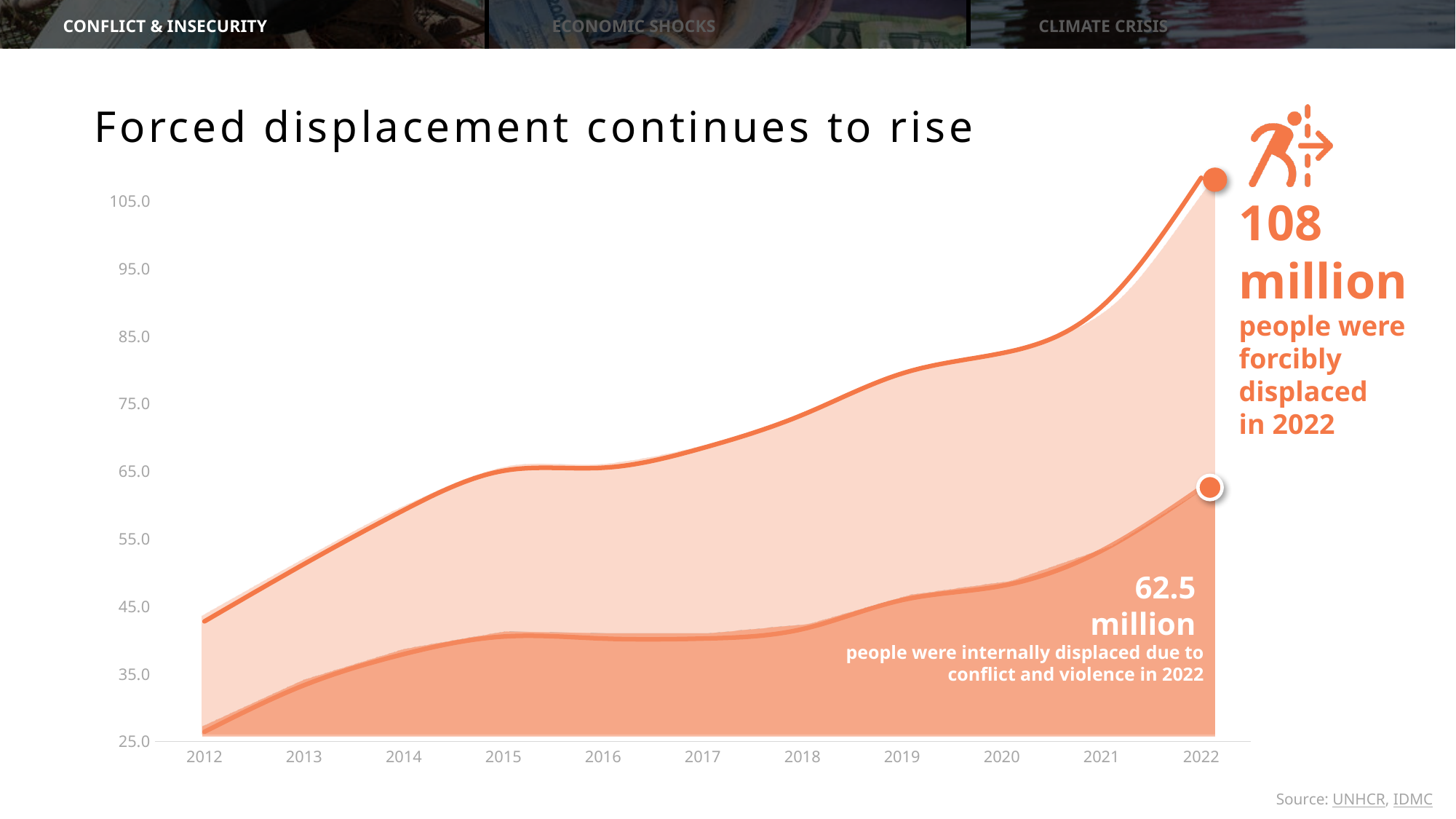
What kind of chart is shown on the slide? area chart How many years are shown along the x axis? 11 Do the values for total forced displacement rise or fall from 2012 to 2022? rise How many people were internally displaced due to conflict and violence in 2022? 62.5 million In which year is the internally displaced series at its lowest value? 2012 Is the value for total forced displacement in 2019 greater or less than 75.0? greater Is the value for total forced displacement in 2012 greater or less than 45.0? less Which sources are cited for the chart? UNHCR, IDMC What is the difference between the total forcibly displaced and the internally displaced figures for 2022? 45.5 million What is the title of the chart? Forced displacement continues to rise In which year does the total forced displacement series reach its highest value? 2022 How many people were forcibly displaced in 2022 according to the slide? 108 million